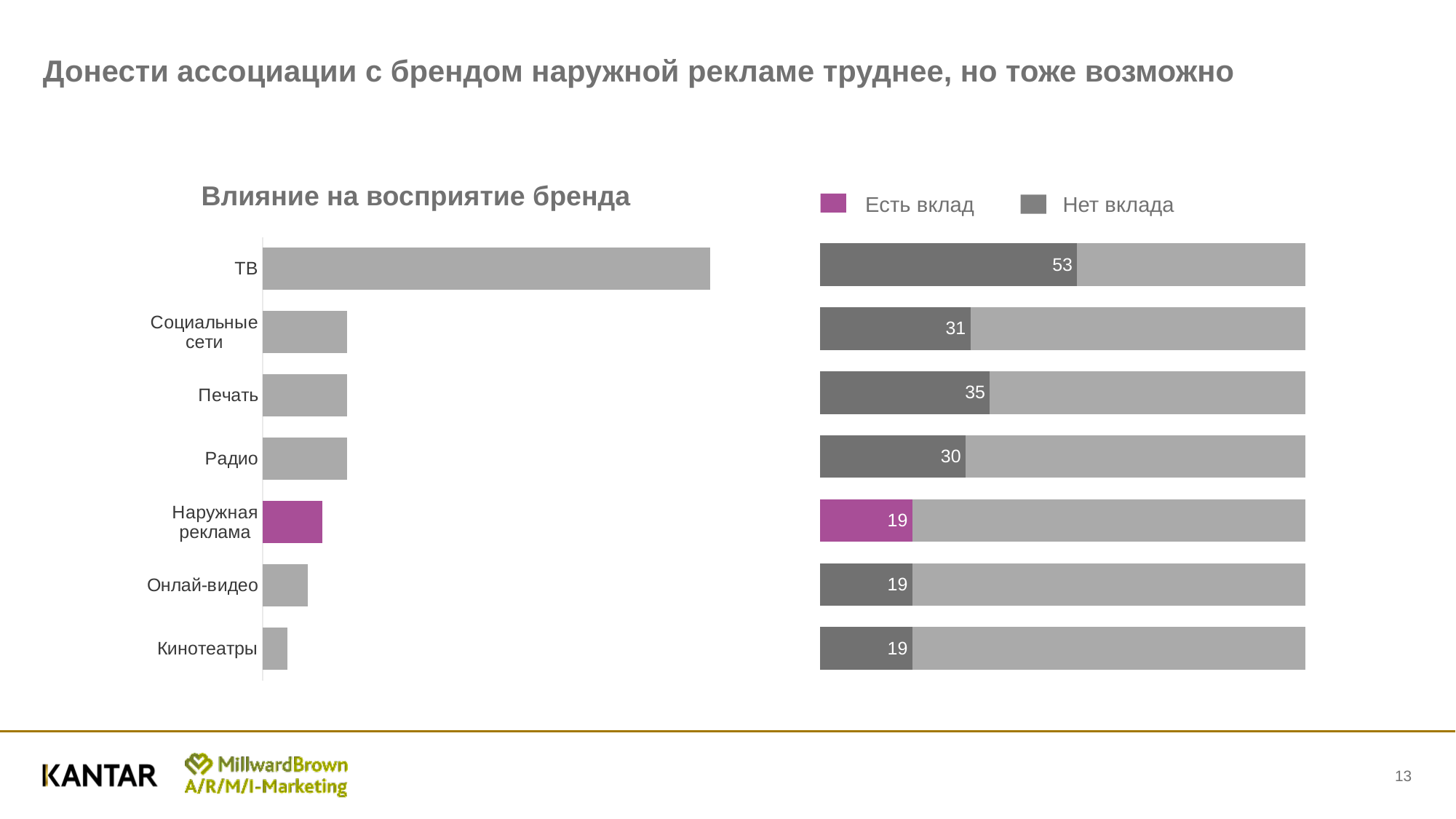
How many series does the legend of the right-hand stacked bar chart list? 2 In the right-hand stacked bar chart, what is the 'Есть вклад' value for Печать? 35 In the right-hand stacked bar chart, what is the 'Есть вклад' value for Наружная реклама? 19 In the right-hand stacked bar chart, which category has the highest 'Есть вклад' value? ТВ In the right-hand stacked bar chart, which has a larger 'Есть вклад' value, Печать or Радио? Печать In the right-hand stacked bar chart, what is the 'Есть вклад' value for ТВ? 53 What type of chart is 'Влияние на восприятие бренда'? Bar chart In the chart titled 'Влияние на восприятие бренда', which category has the longest bar? ТВ How many categories are shown in the chart titled 'Влияние на восприятие бренда'? 7 In the right-hand stacked bar chart, what is the difference between the 'Есть вклад' values for ТВ and Социальные сети? 22 In the right-hand stacked bar chart, what is the 'Есть вклад' value for Социальные сети? 31 In the chart titled 'Влияние на восприятие бренда', which category has the shortest bar? Кинотеатры